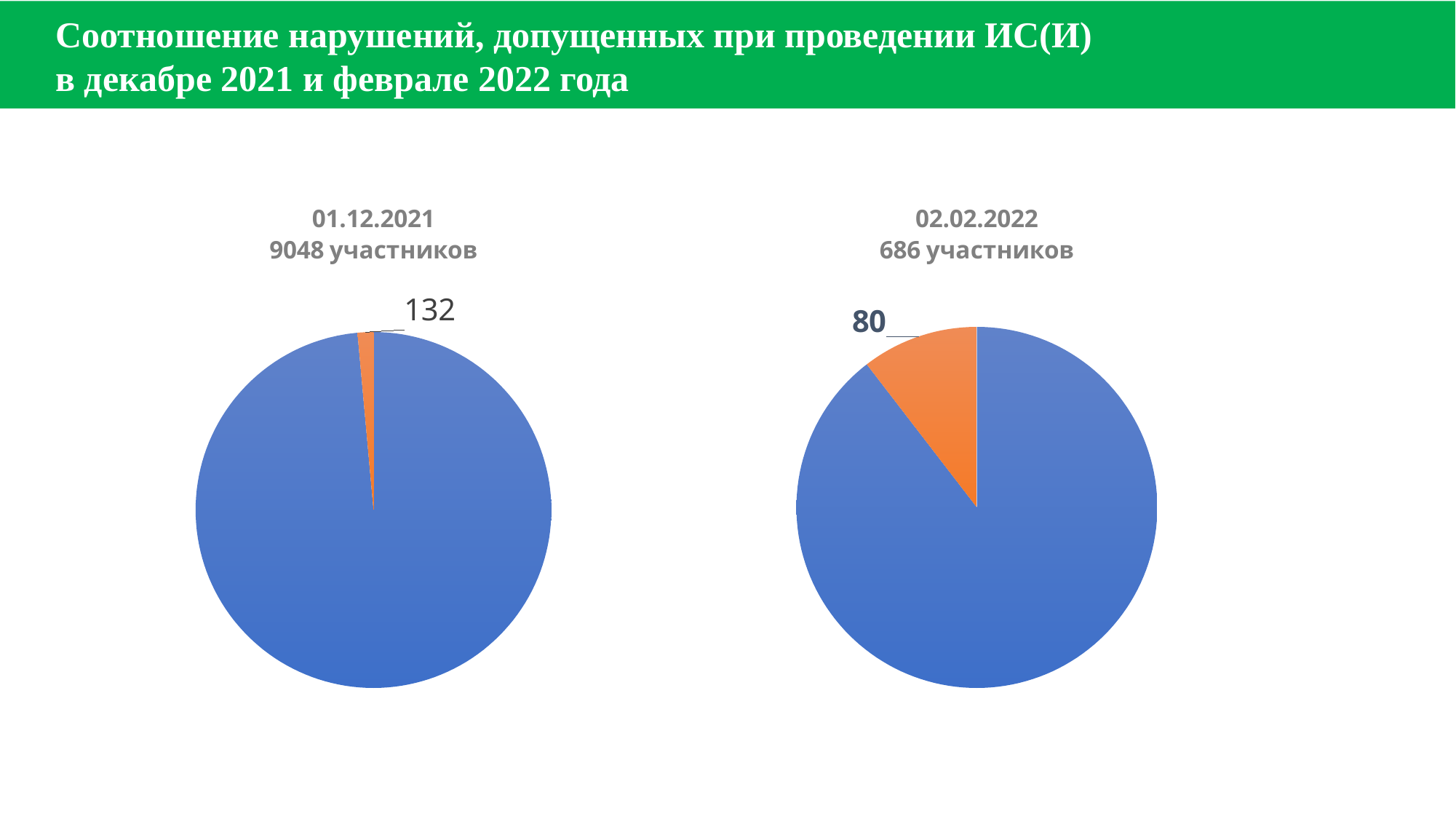
In the left chart (01.12.2021), what value is printed on the orange slice? 132 In the right chart (02.02.2022), what value is printed on the orange slice? 80 How many slices does the right chart (02.02.2022) have? 2 Which is larger: the labelled orange slice in the left chart (01.12.2021) or the labelled orange slice in the right chart (02.02.2022)? the left chart (132) In the left chart (01.12.2021), which slice is the smallest, the blue one or the orange one? the orange one What kind of chart is the right chart titled "02.02.2022 686 участников"? pie chart What is the difference between the labelled value in the left chart (132) and the labelled value in the right chart (80)? 52 What kind of chart is the left chart titled "01.12.2021 9048 участников"? pie chart How many slices does the left chart (01.12.2021) have? 2 In the right chart (02.02.2022), which slice is the largest, the blue one or the orange one? the blue one What colour is the slice labelled 132 in the left chart? orange What is the title of the right chart? 02.02.2022 686 участников